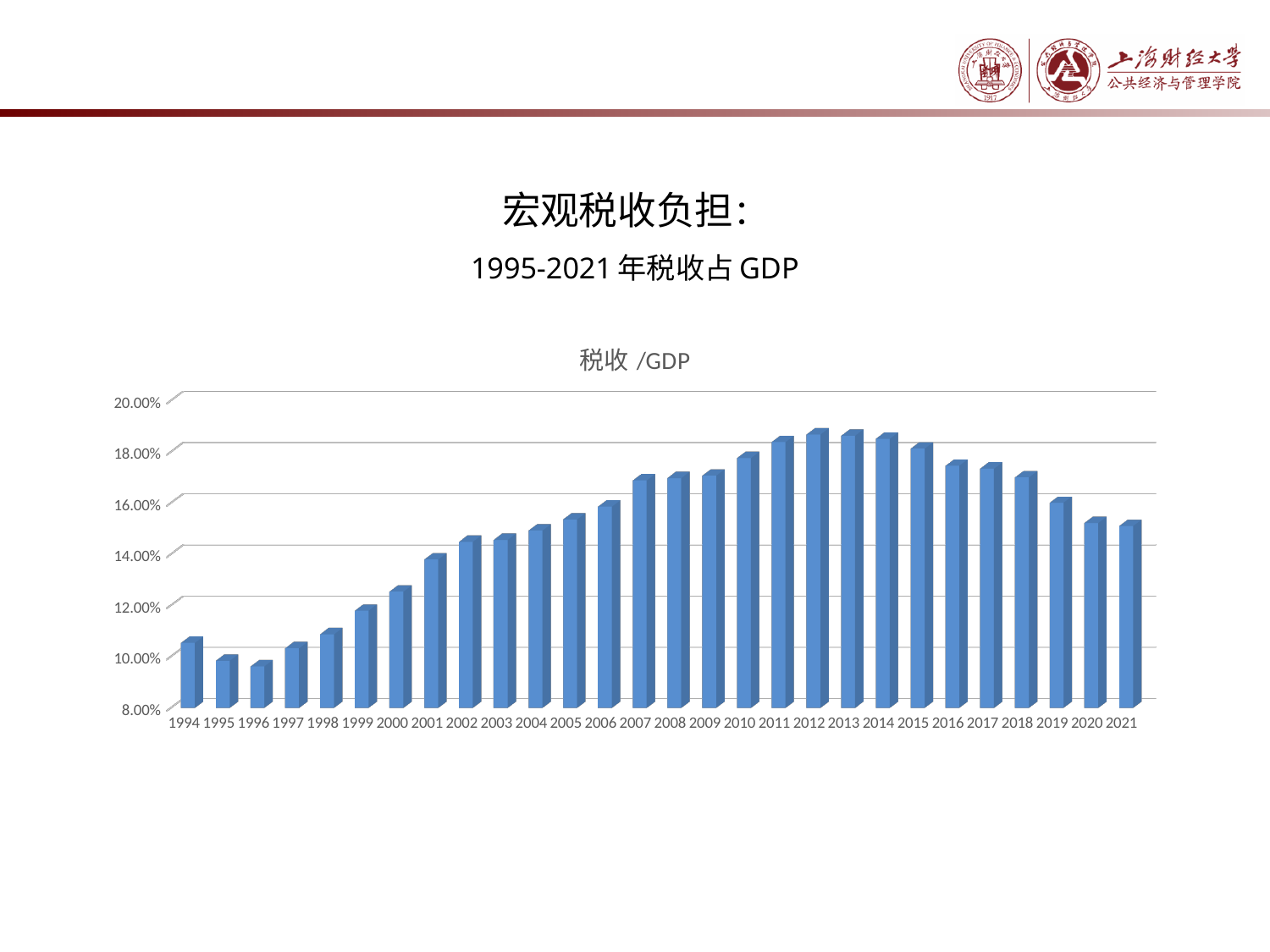
How many years (bars) are plotted in the chart? 28 Which is larger, the value for 2001 or the value for 2011? 2011 Is the value for 2001 greater or less than 14.00%? less Is the value for 2012 greater or less than 18.00%? greater Do the values rise or fall from 1996 to 2012? rise Is the value for 2007 greater or less than 16.00%? greater Which year has the lowest value in the chart? 1996 What is the title of the chart? 税收 /GDP What kind of chart is shown on the slide? bar chart Which is larger, the value for 2000 or the value for 2019? 2019